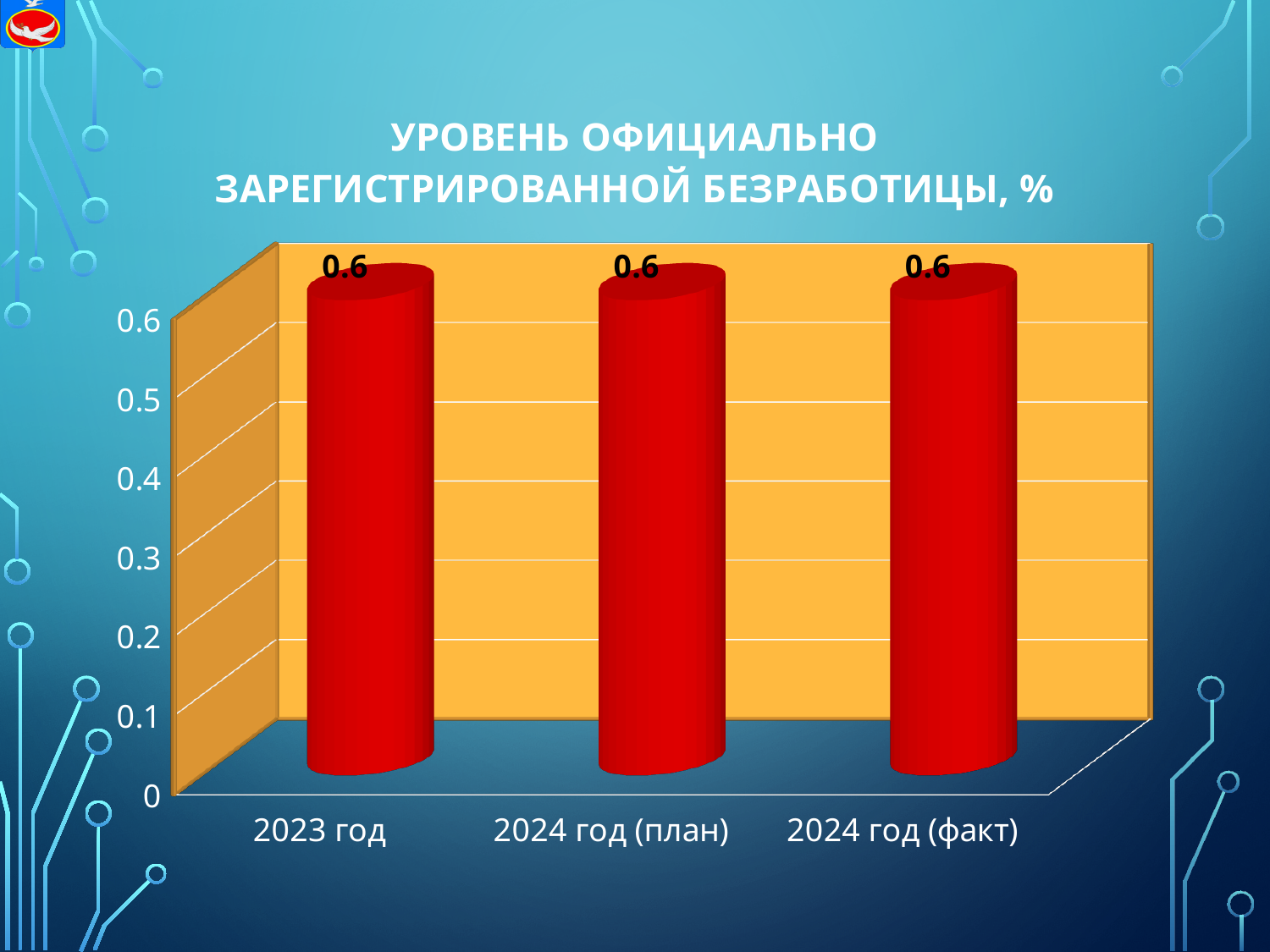
Is the value for 2024 год (факт) greater or less than 0.3? greater What is the title of the chart? УРОВЕНЬ ОФИЦИАЛЬНО ЗАРЕГИСТРИРОВАННОЙ БЕЗРАБОТИЦЫ, % How many categories are shown on the x axis? 3 Is the value for 2023 год greater or less than 0.5? greater What is the value for 2023 год? 0.6 What kind of chart is shown on the slide? Bar chart What is the value for 2024 год (план)? 0.6 What is the value for 2024 год (факт)? 0.6 Do the values rise, fall or stay the same from 2023 год to 2024 год (факт)? Stay the same Which is larger, the value for 2023 год or the value for 2024 год (план)? They are equal What colour are the bars in the chart? Red What is the difference between the values for 2024 год (план) and 2024 год (факт)? 0